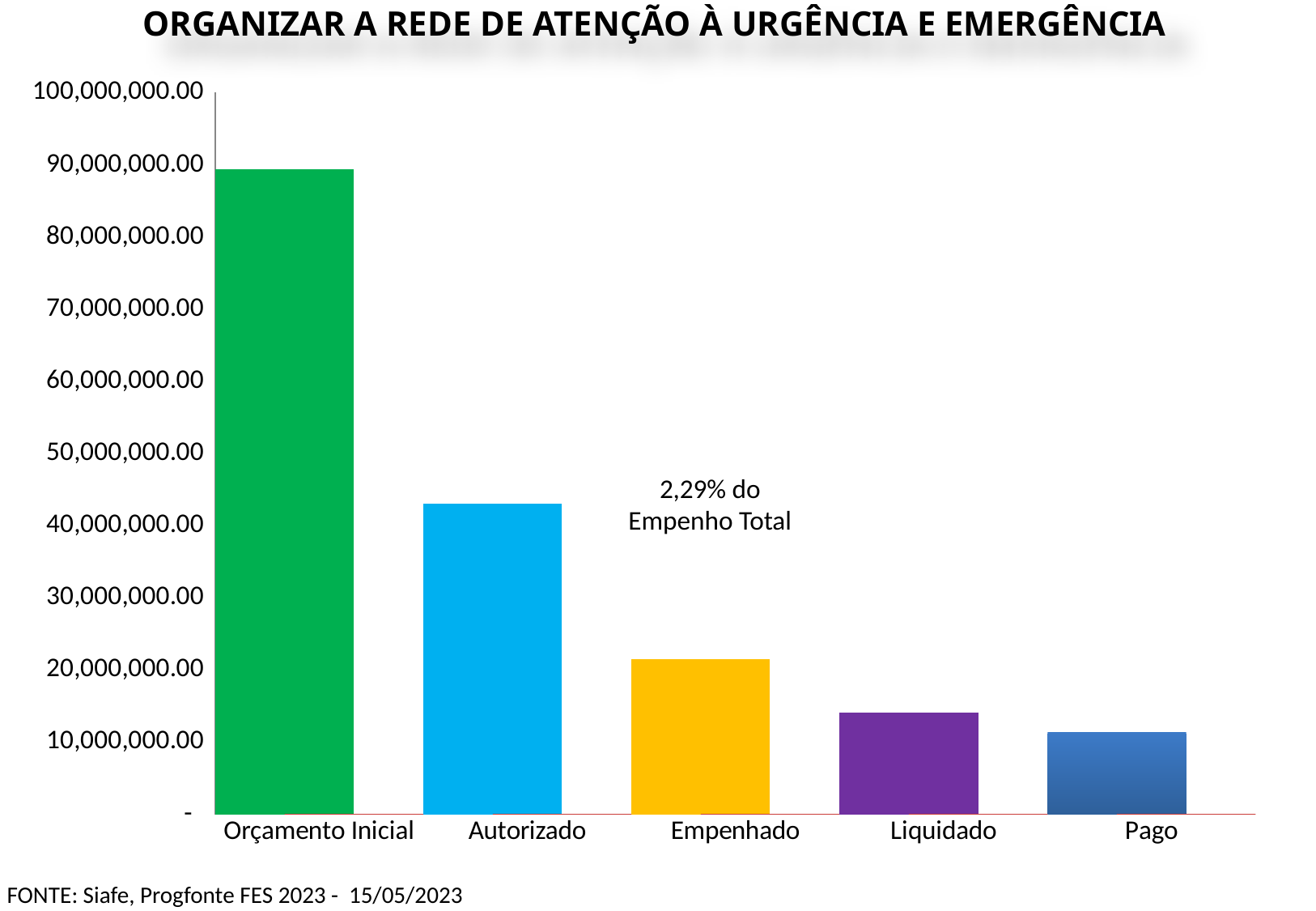
Which category has the lowest value in the chart? Pago Is the value for Liquidado greater or less than 10,000,000.00? greater Is the value for Orçamento Inicial greater or less than 80,000,000.00? greater What type of chart is shown on the slide? bar chart What is the title of the chart? ORGANIZAR A REDE DE ATENÇÃO À URGÊNCIA E EMERGÊNCIA Which is larger, the value for Empenhado or the value for Liquidado? Empenhado Which category has the highest value in the chart? Orçamento Inicial Do the values rise or fall from left to right along the x axis? fall Is the value for Pago greater or less than 20,000,000.00? less How many categories are shown on the x axis of the chart? 5